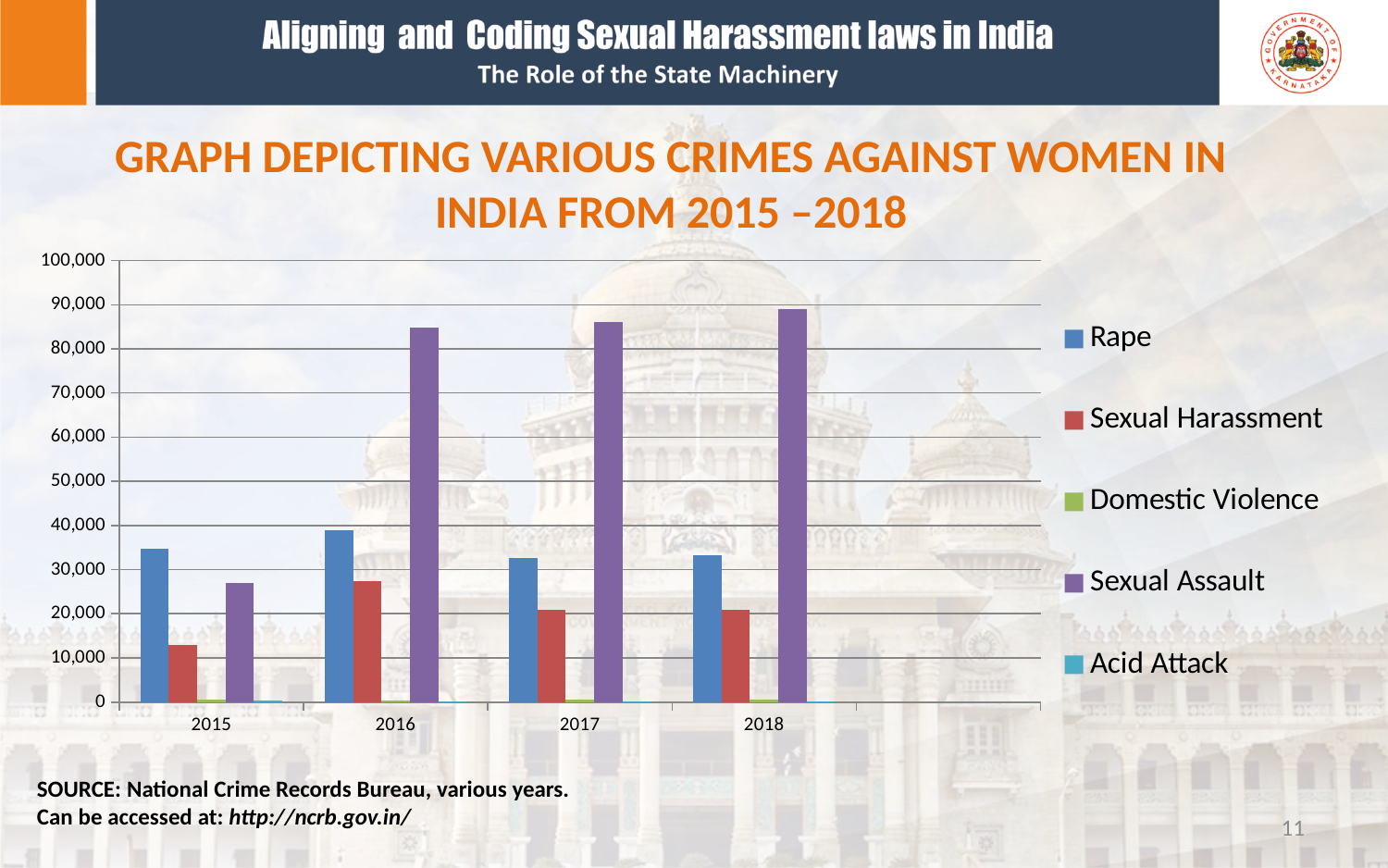
In 2015, which is larger: the value for Rape or the value for Sexual Harassment? Rape Does the value for Sexual Assault rise or fall from 2015 to 2016? Rise Is the value for Sexual Assault in 2015 greater or less than 20,000? greater Is the value for Sexual Assault in 2016 greater or less than 80,000? greater Is the value for Rape in 2015 greater or less than 40,000? less In which year is the Sexual Assault bar the lowest? 2015 How many years are shown along the x axis of the chart? 4 What kind of chart is shown on the slide? Bar chart Which series is shown in purple in the chart's legend? Sexual Assault In which year is the Rape bar the highest? 2016 How many series does the chart's legend list? 5